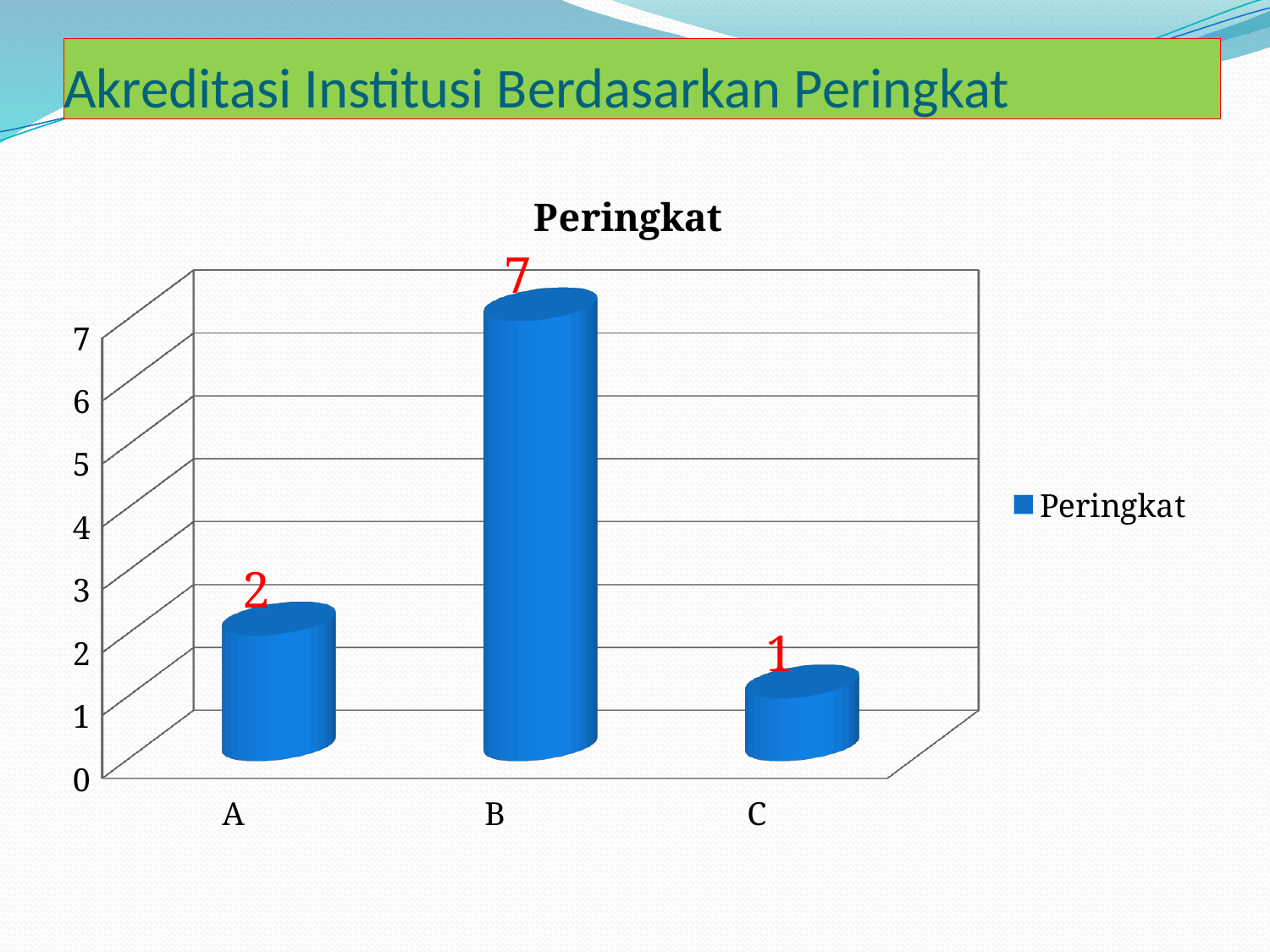
What is the value for category A? 2 Which category has the highest value? B What is the value for category C? 1 Is the value for B greater or less than 5? greater How many categories are shown on the x axis? 3 What kind of chart is shown on the slide? bar chart Which category has the lowest value? C Which is larger, the value for A or the value for C? A What is the difference between the values for B and A? 5 What is the difference between the values for A and C? 1 What is the value for category B? 7 What is the title of the chart? Peringkat